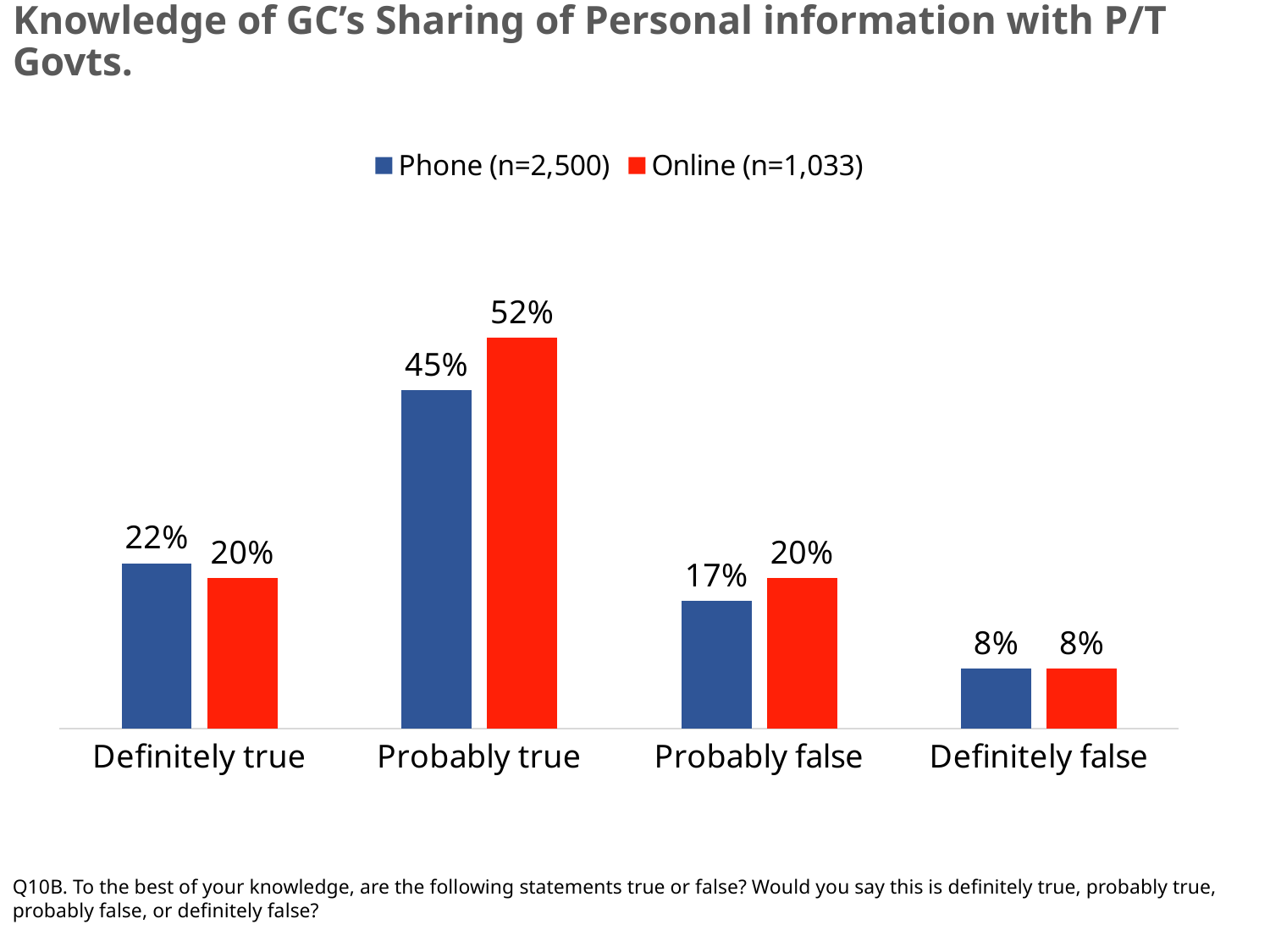
Which category has the lowest Phone value? Definitely false What is the Online value for Definitely true? 20% What is the Online value for Probably false? 20% What is the Phone value for Probably true? 45% What is the difference between the Online and Phone values for Probably true? 7% What kind of chart is shown on the slide? Bar chart What is the difference between the Phone values for Definitely true and Probably false? 5% How many series does the legend list? 2 What is the sample size for the Online series shown in the legend? n=1,033 Which category has the highest Online value? Probably true How many categories are shown on the x axis? 4 Which is larger for Definitely true, the Phone value or the Online value? Phone